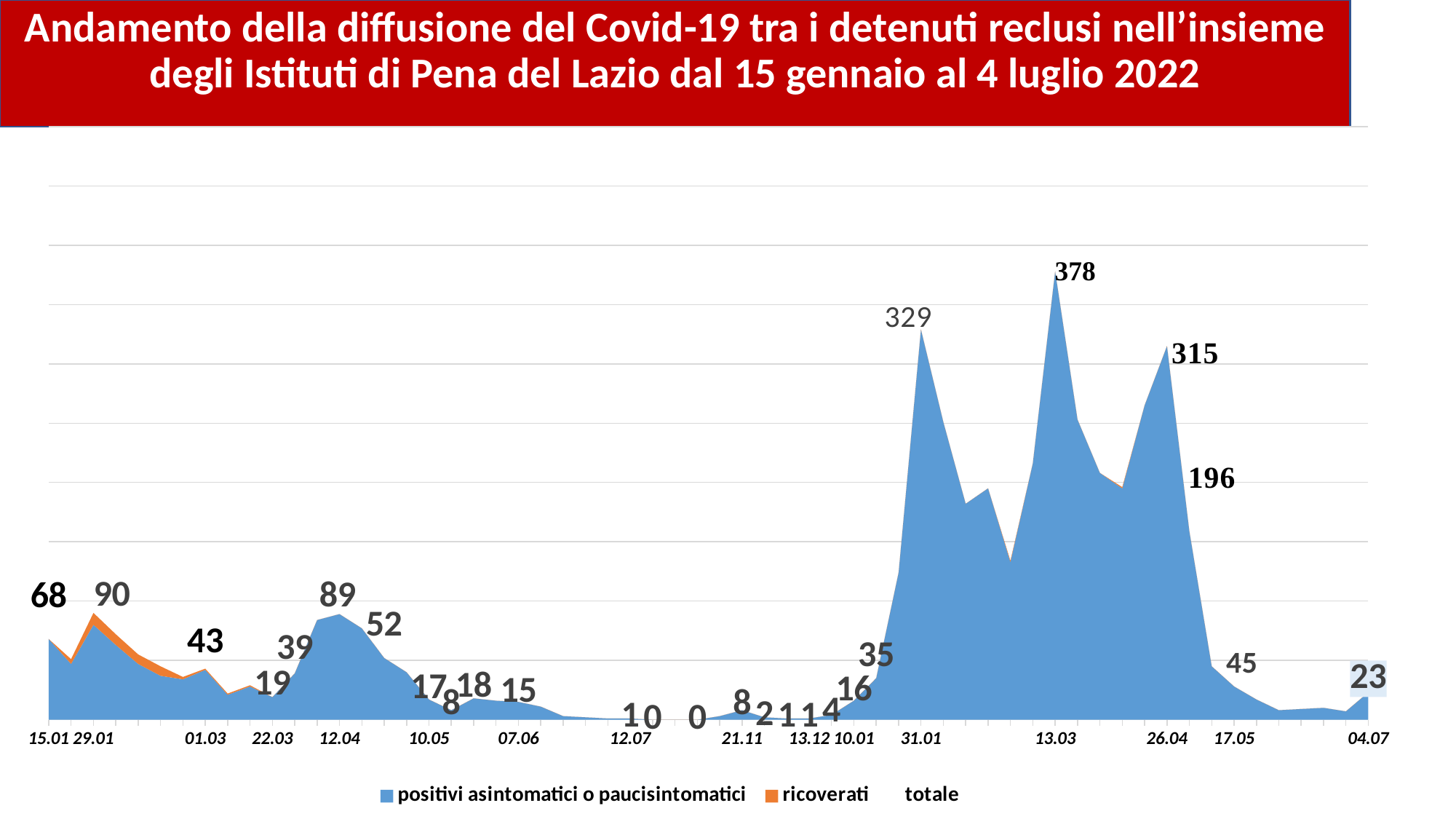
What kind of chart is shown on the slide? Area chart What is the value labelled at the first date, 15.01? 68 Which date has the highest labelled value? 13.03 What is the total value labelled at 26.04? 315 What is the value labelled at the last date, 04.07? 23 What is the difference between the peak at 13.03 (378) and the peak at 31.01 (329)? 49 What is the total value labelled at 13.03? 378 What is the total value labelled at 31.01? 329 Which is larger, the value at 31.01 or the value at 26.04? 31.01 What is the highest value labelled on the chart? 378 Do the values rise or fall from 26.04 to 04.07? Fall How many series does the legend list? 3